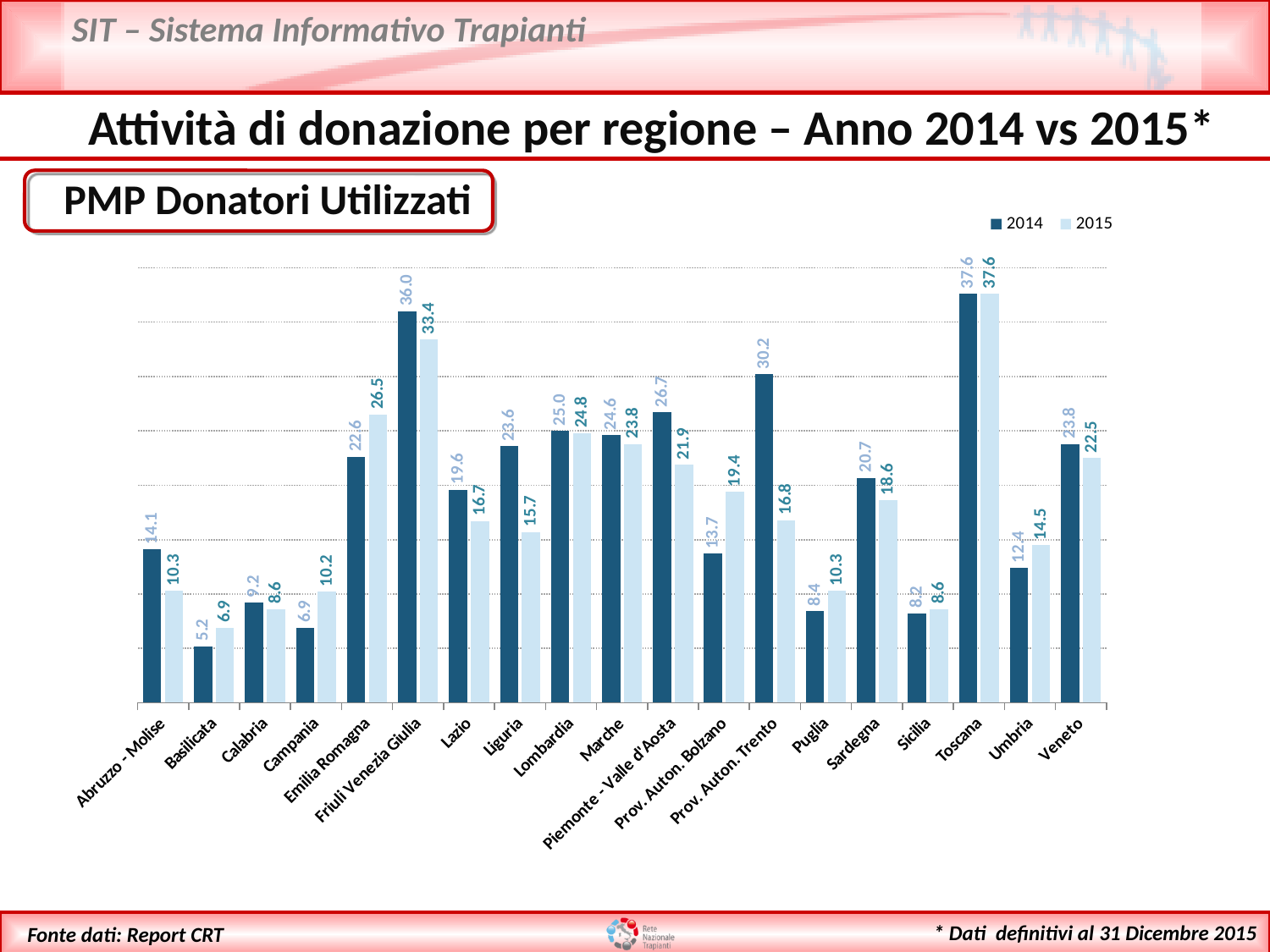
What is the 2014 value for Prov. Auton. Trento? 30.2 Which region has the lowest 2014 value? Basilicata What is the 2015 value for Emilia Romagna? 26.5 How many regions are shown on the x axis? 19 What type of chart is shown on the slide? Bar chart What is the 2015 value for Lazio? 16.7 What is the difference between the 2014 and 2015 values for Prov. Auton. Trento? 13.4 How many series does the legend list? 2 Which region has the lowest 2015 value? Basilicata Which is larger for Campania: the 2014 value or the 2015 value? 2015 Which is larger for Liguria: the 2014 value or the 2015 value? 2014 Which region has the highest 2014 value? Toscana